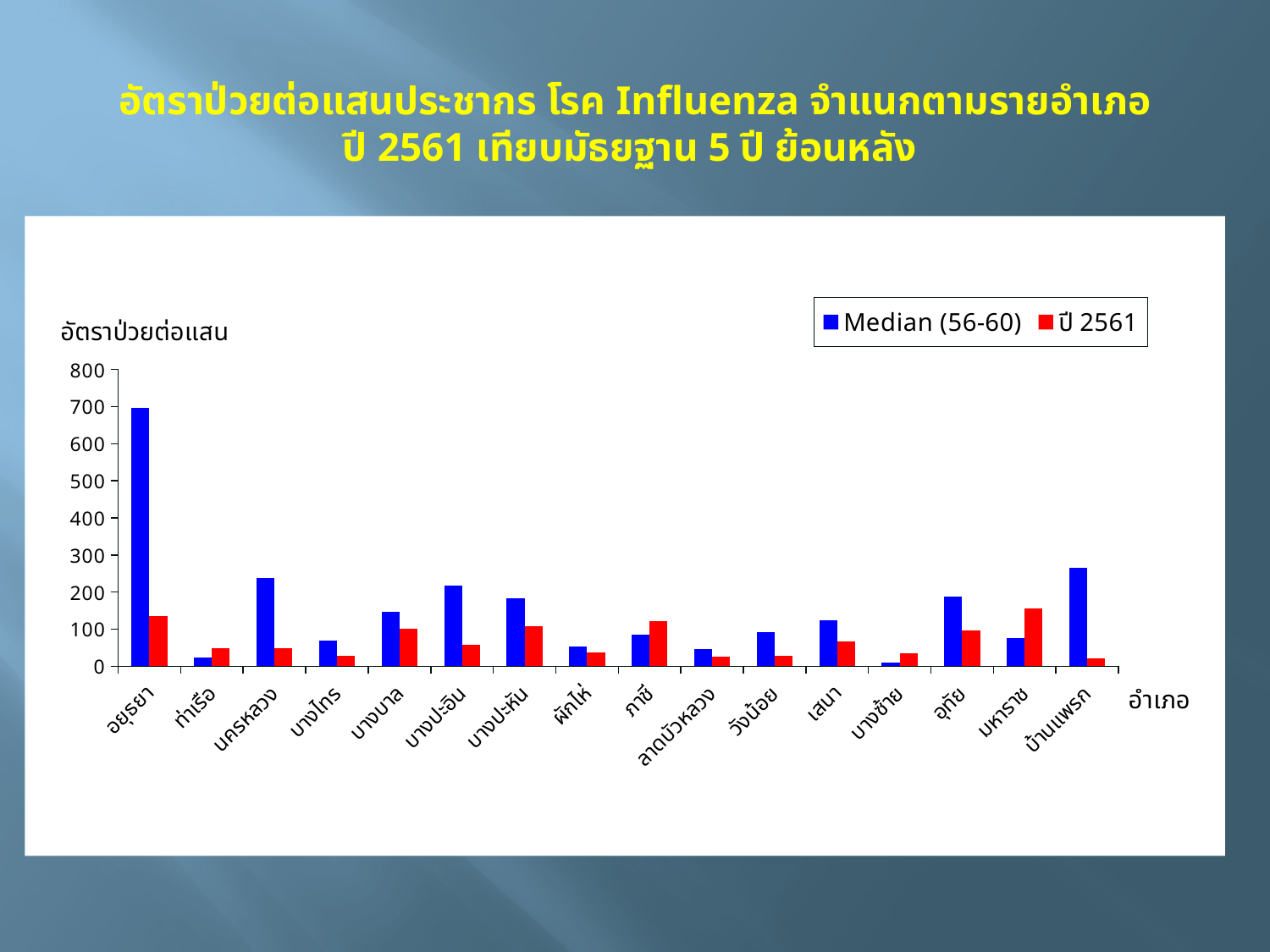
How many series does the legend list? 2 Is the ปี 2561 value for มหาราช greater or less than 100? greater Is the Median (56-60) value for อยุธยา greater or less than 600? greater Is the Median (56-60) value for บ้านแพรก greater or less than 200? greater For ภาชี, which is larger: the Median (56-60) value or the ปี 2561 value? ปี 2561 What colour are the bars for the ปี 2561 series? red Which district has the lowest Median (56-60) value? บางซ้าย For บ้านแพรก, which is larger: the Median (56-60) value or the ปี 2561 value? Median (56-60) How many districts (อำเภอ) are shown on the x axis? 16 What kind of chart is shown on the slide? bar chart Which district has the highest Median (56-60) value? อยุธยา